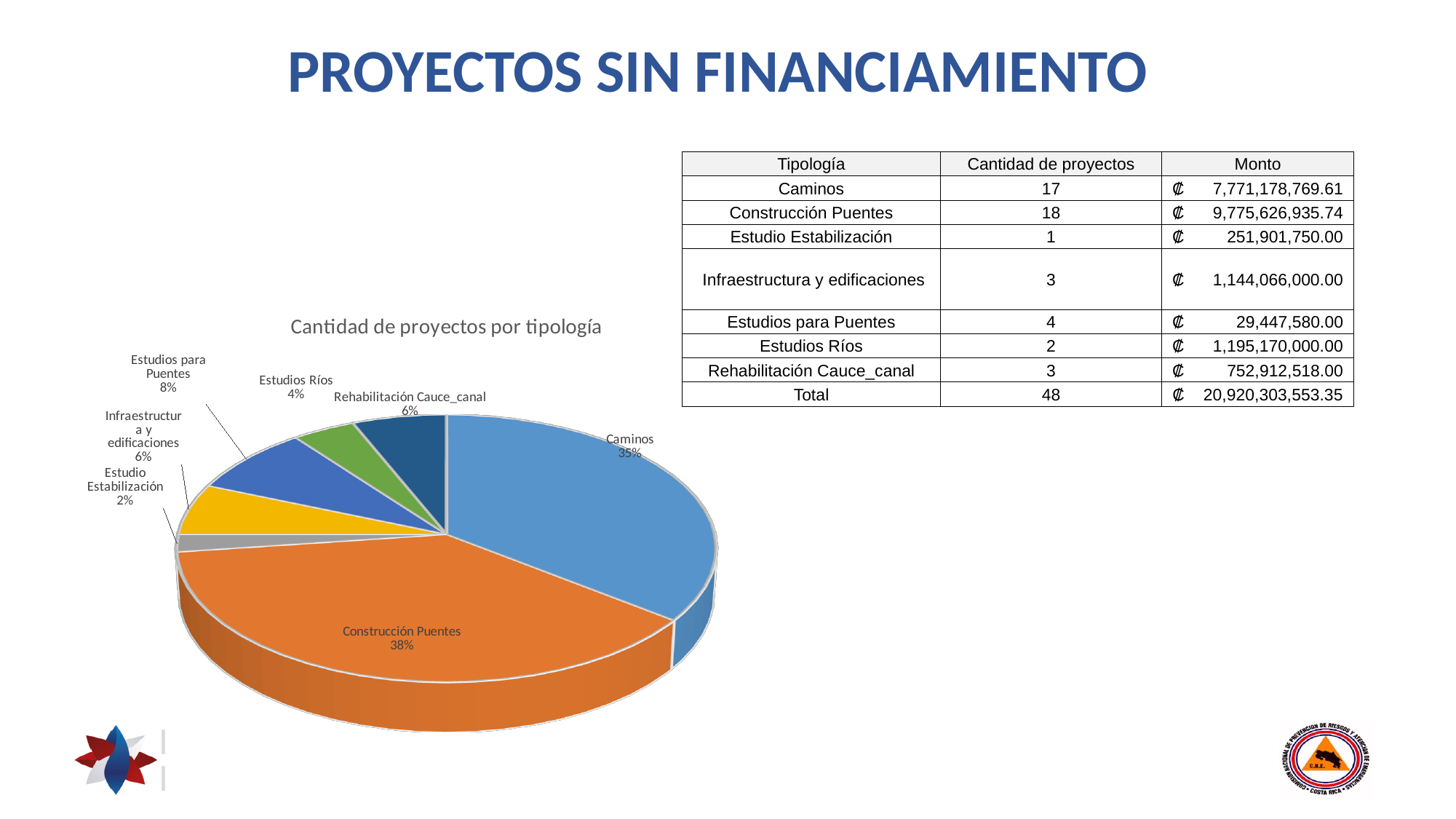
What percentage is shown for Estudios Ríos? 4% Which category has the smallest slice of the pie? Estudio Estabilización What kind of chart is shown on the slide? Pie chart What is the title of the chart? Cantidad de proyectos por tipología How many categories are shown in the pie chart? 7 What share of the pie does Construcción Puentes represent? 38% Which category has the largest slice of the pie? Construcción Puentes What percentage is shown for Estudio Estabilización? 2% Which is larger, the share for Estudios para Puentes or the share for Estudios Ríos? Estudios para Puentes What percentage is shown for Estudios para Puentes? 8% What is the difference in percentage points between Construcción Puentes and Caminos? 3 What share of the pie does Caminos represent? 35%